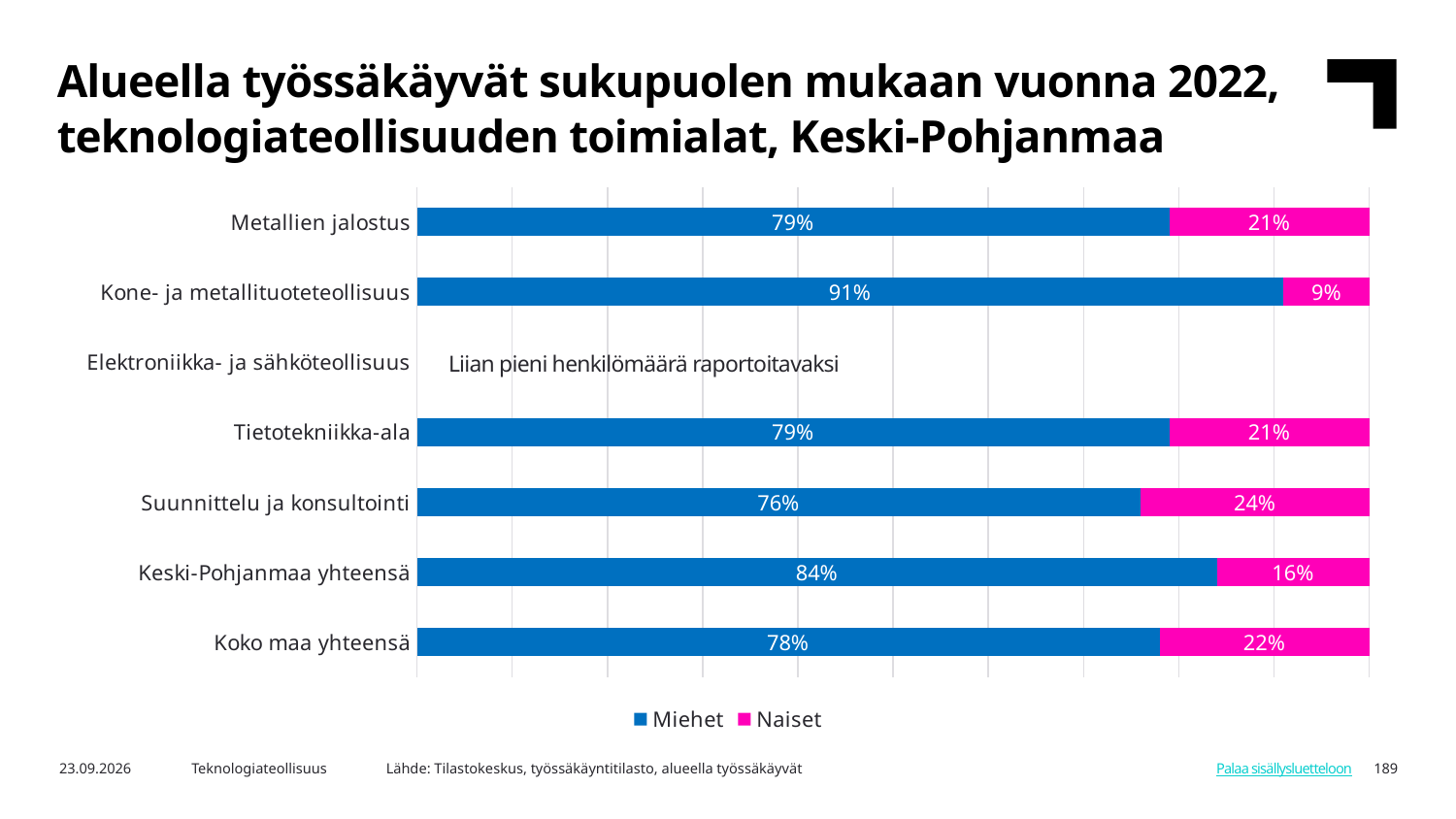
Which category has the lowest Miehet share? Suunnittelu ja konsultointi What is the Naiset share for Suunnittelu ja konsultointi? 24% What is the Naiset share for Keski-Pohjanmaa yhteensä? 16% What is the difference between the Miehet share for Keski-Pohjanmaa yhteensä and Koko maa yhteensä? 6 percentage points What is the Miehet share for Kone- ja metallituoteteollisuus? 91% Which category has the highest Miehet share? Kone- ja metallituoteteollisuus Which category has no bar plotted, and what text is shown instead? Elektroniikka- ja sähköteollisuus; Liian pieni henkilömäärä raportoitavaksi What is the Miehet share for Koko maa yhteensä? 78% Which is larger, the Naiset share for Metallien jalostus or for Kone- ja metallituoteteollisuus? Metallien jalostus How many series does the legend list? 2 What is the total of the stacked bar for Tietotekniikka-ala? 100% What kind of chart is shown on the slide? Stacked bar chart